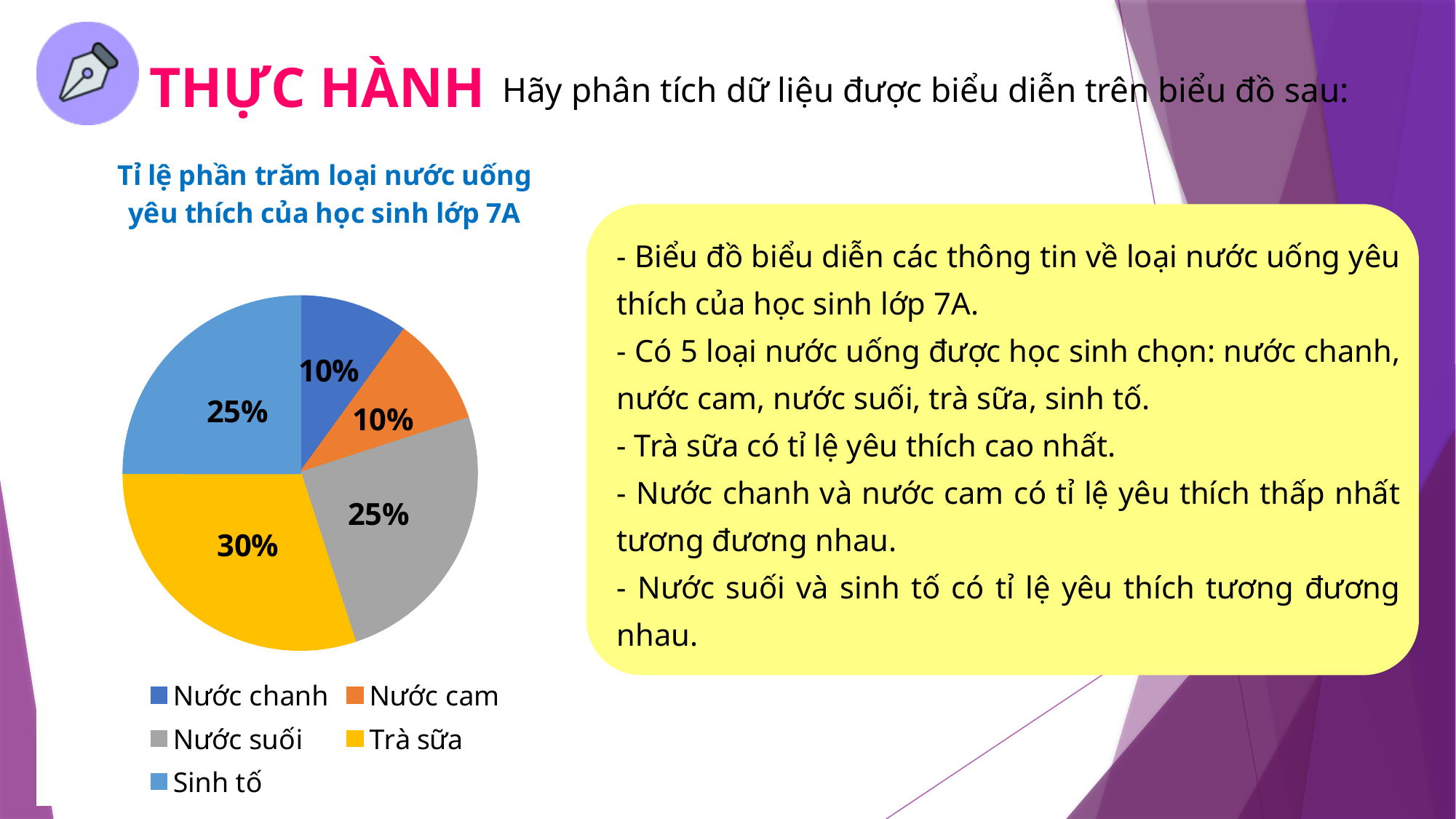
How many categories of drinks are shown in the pie chart? 5 What is the combined share of Nước chanh and Nước cam in the pie chart? 20% What is the value shown for Nước suối in the pie chart? 25% What type of chart is shown on the slide? Pie chart What percentage of students in class 7A prefer Trà sữa according to the pie chart? 30% Which is larger in the pie chart, the share for Trà sữa or the share for Sinh tố? Trà sữa What is the value for Sinh tố in the pie chart? 25% What is the title of the chart on the slide? Tỉ lệ phần trăm loại nước uống yêu thích của học sinh lớp 7A Which two drinks share the smallest slice of the pie chart? Nước chanh and Nước cam What is the difference in percentage points between Trà sữa and Nước suối? 5 percentage points Which drink has the largest share in the pie chart? Trà sữa What percentage does the pie chart show for Nước cam? 10%